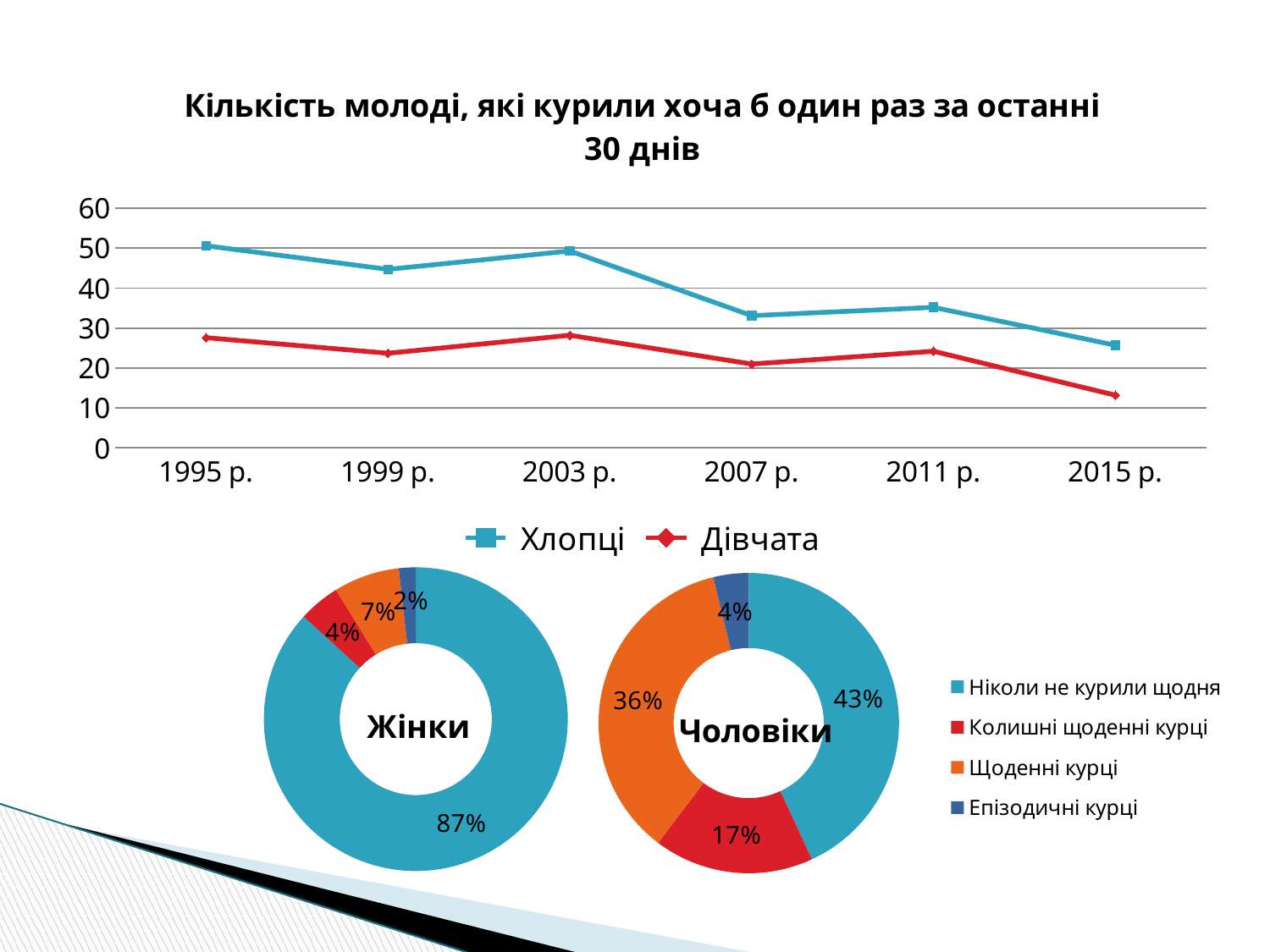
In the Чоловіки doughnut chart, what is the difference between the shares of Ніколи не курили щодня and Колишні щоденні курці? 26% What kind of chart is the top chart titled «Кількість молоді, які курили хоча б один раз за останні 30 днів»? line chart In the top line chart, does the Хлопці line rise or fall overall from 1995 р. to 2015 р.? fall How many series does the legend of the top line chart list? 2 In the top line chart, is the value for Хлопці in 2007 р. greater or less than 30? greater In the top line chart, which series has the higher value in 2003 р., Хлопці or Дівчата? Хлопці In the Чоловіки doughnut chart, which category has the largest share? Ніколи не курили щодня How many years are shown on the x axis of the top line chart? 6 In the Жінки doughnut chart, which category has the smallest share? Епізодичні курці In the top line chart, is the value for Дівчата in 2015 р. greater or less than 20? less In the Жінки doughnut chart, what share is Ніколи не курили щодня? 87% In the Чоловіки doughnut chart, what share is Щоденні курці? 36%